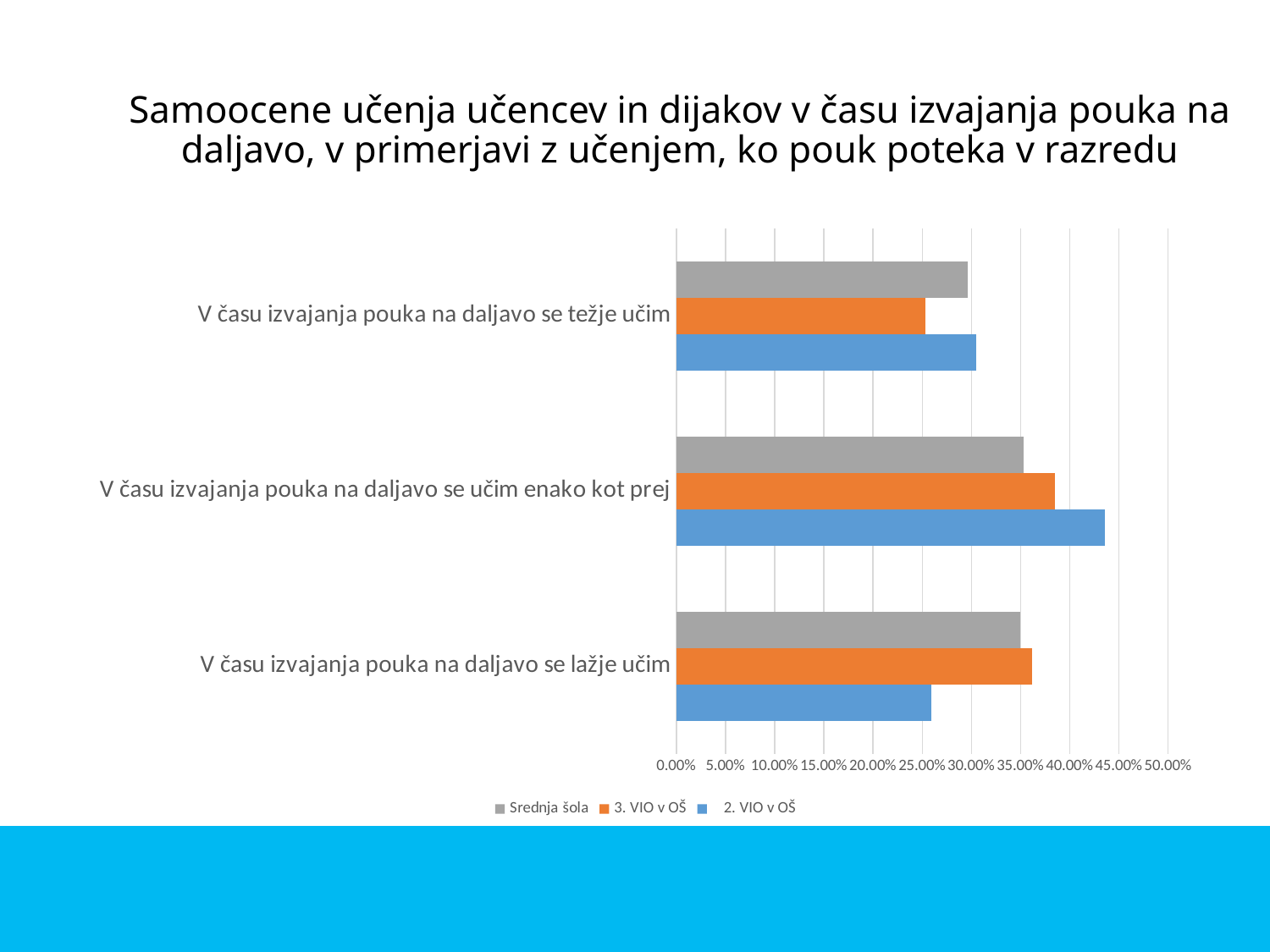
What kind of chart is shown on the slide? bar chart How many categories are shown on the chart? 3 Is the value for 2. VIO v OŠ in "V času izvajanja pouka na daljavo se lažje učim" greater or less than 30.00%? less Is the value for 2. VIO v OŠ in "V času izvajanja pouka na daljavo se učim enako kot prej" greater or less than 40.00%? greater Which series is shown in orange in the legend? 3. VIO v OŠ How many series does the legend list? 3 Which series has the lowest value for "V času izvajanja pouka na daljavo se težje učim"? 3. VIO v OŠ Is the value for 3. VIO v OŠ in "V času izvajanja pouka na daljavo se težje učim" greater or less than 30.00%? less Which series has the lowest value for "V času izvajanja pouka na daljavo se lažje učim"? 2. VIO v OŠ Which series has the highest value for "V času izvajanja pouka na daljavo se učim enako kot prej"? 2. VIO v OŠ For 2. VIO v OŠ, which is larger: the value for "se učim enako kot prej" or the value for "se težje učim"? se učim enako kot prej Which series is shown in blue in the legend? 2. VIO v OŠ